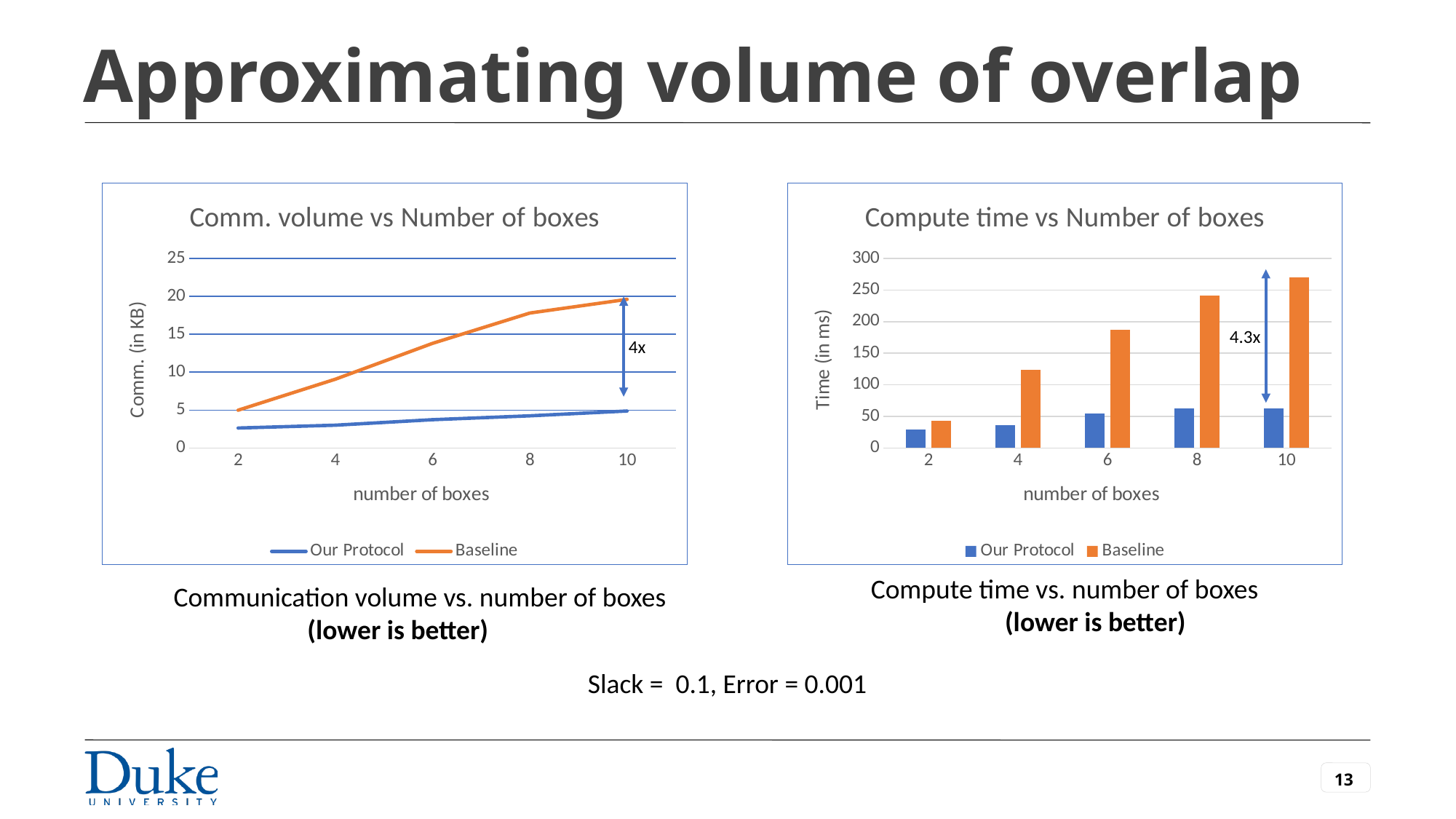
What kind of chart is the 'Comm. volume vs Number of boxes' chart on the left? line chart In the 'Comm. volume vs Number of boxes' chart, is the Baseline value at 10 boxes greater or less than 15? greater In the 'Compute time vs Number of boxes' chart, which series has the higher value at 8 boxes, Our Protocol or Baseline? Baseline In the 'Compute time vs Number of boxes' chart, at which number of boxes is the Baseline bar tallest? 10 In the 'Compute time vs Number of boxes' chart, how many series does the legend list? 2 In the 'Compute time vs Number of boxes' chart, is the Baseline value at 10 boxes greater or less than 250? greater In the 'Comm. volume vs Number of boxes' chart, how many values of number of boxes are plotted on the x axis? 5 In the 'Compute time vs Number of boxes' chart, is the Baseline value at 4 boxes greater or less than 100? greater What kind of chart is the 'Compute time vs Number of boxes' chart on the right? bar chart In the 'Comm. volume vs Number of boxes' chart, does the Baseline line rise or fall as the number of boxes increases? rises What speedup factor is annotated at 10 boxes in the 'Compute time vs Number of boxes' chart? 4.3x